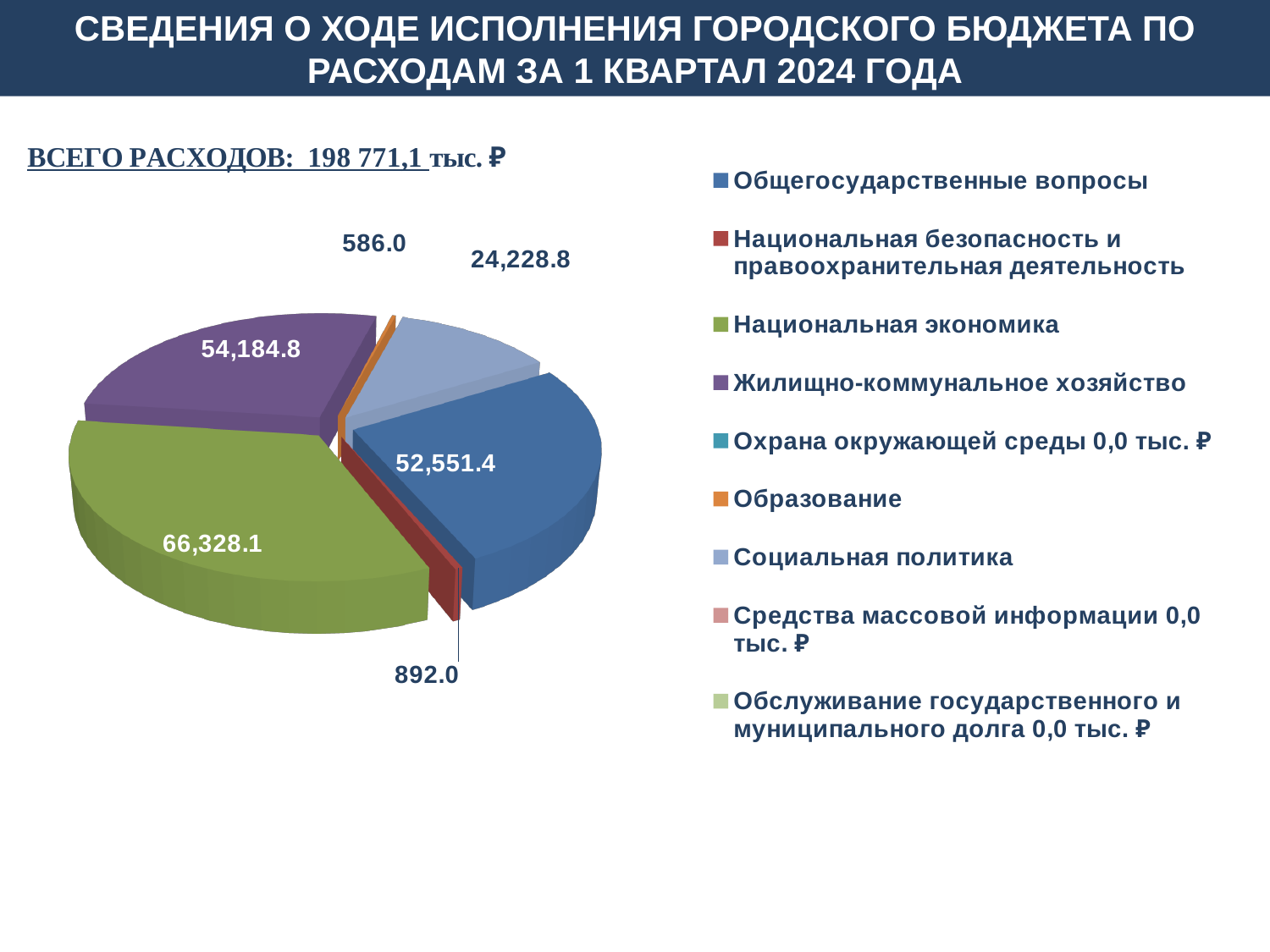
What total expenditure amount is stated above the chart? 198 771,1 тыс. ₽ Which is larger: the value for Жилищно-коммунальное хозяйство or the value for Социальная политика? Жилищно-коммунальное хозяйство How many categories does the legend list? 9 What is the difference between the values for Национальная экономика and Жилищно-коммунальное хозяйство? 12,143.3 What is the value shown for Национальная безопасность и правоохранительная деятельность? 892.0 What is the value shown for Общегосударственные вопросы? 52,551.4 What is the value shown for Национальная экономика? 66,328.1 What is the value shown for Образование? 586.0 What is the value shown for Социальная политика? 24,228.8 What kind of chart is shown on the slide? pie chart Which category has the largest slice of the pie? Национальная экономика What is the value shown for Жилищно-коммунальное хозяйство? 54,184.8